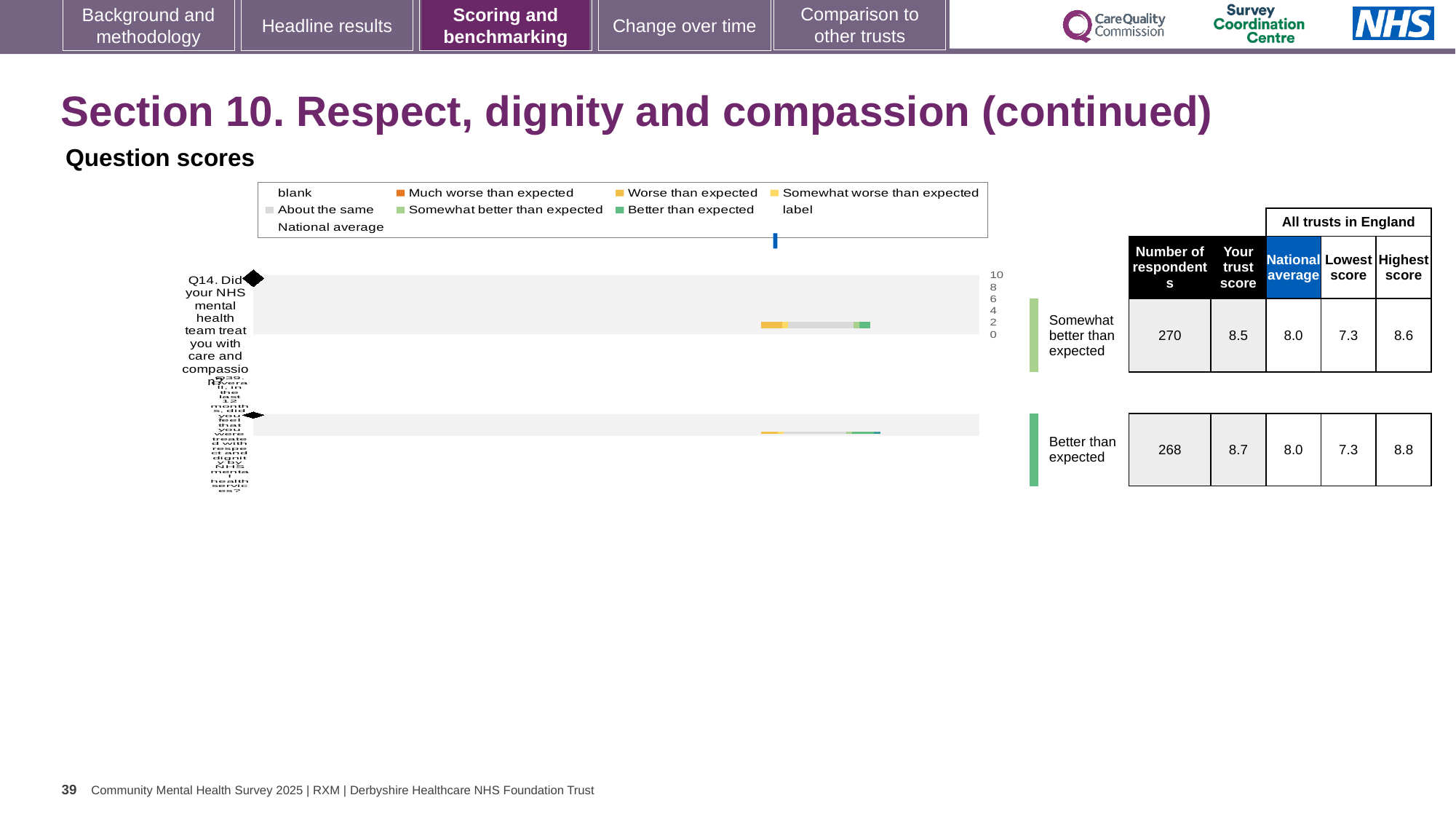
How is the trust's result for Q14 categorised relative to expectation? Somewhat better than expected What is the highest score among all trusts in England for Q39? 8.8 What kind of chart is shown under 'Question scores'? bar chart What is the lowest score among all trusts in England for Q14? 7.3 How is the trust's result for Q39 categorised relative to expectation? Better than expected What is the trust score for Q39, the second question in the chart? 8.7 How many respondents answered Q14? 270 Which question has the higher trust score, Q14 or Q39? Q39 What is the difference between the trust scores for Q39 and Q14? 0.2 How many questions are plotted in the Question scores chart? 2 What is the national average score for Q14? 8.0 What is the trust score for Q14 (Did your NHS mental health team treat you with care and compassion?)? 8.5